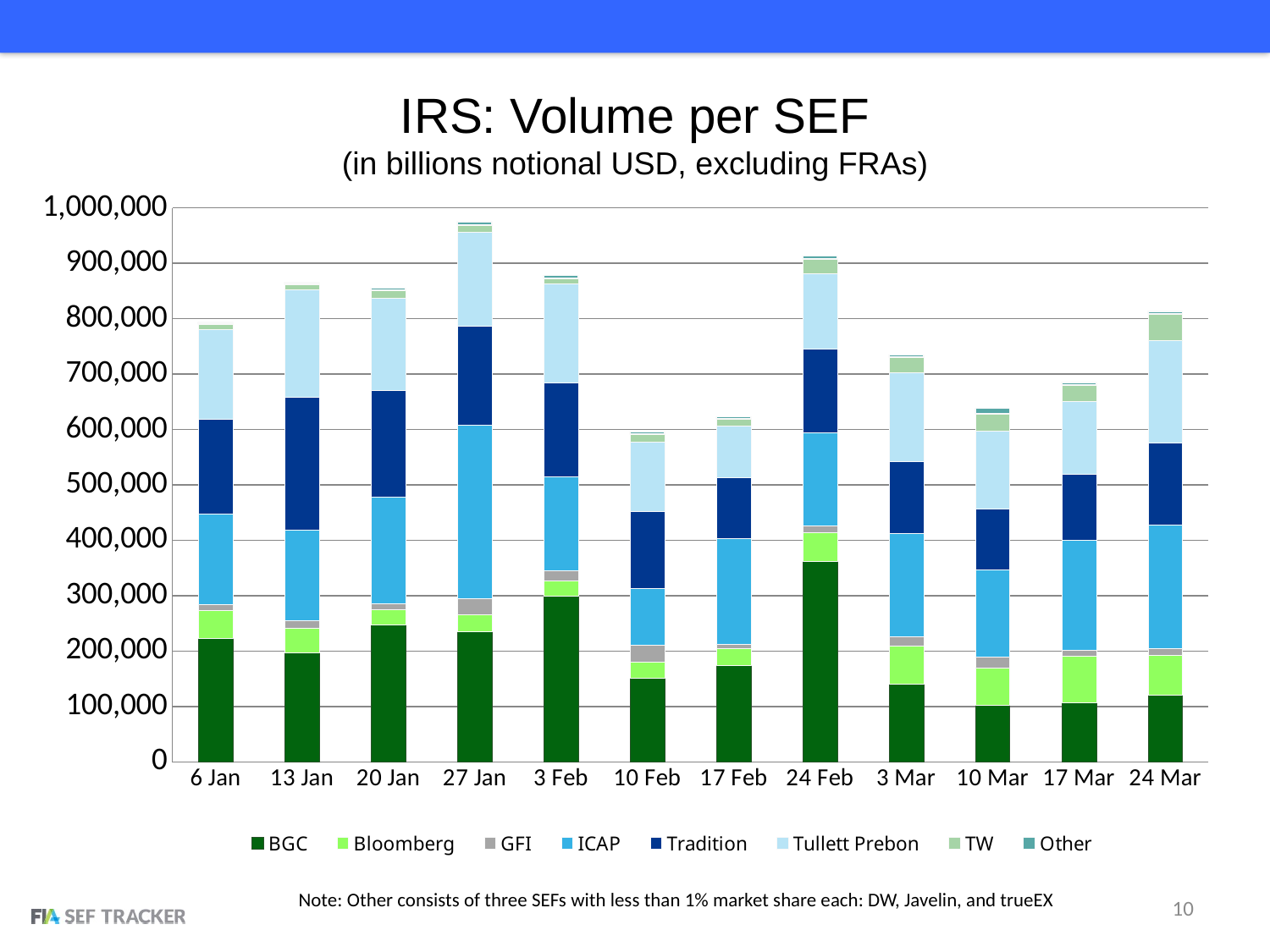
What is the title of the chart? IRS: Volume per SEF On which date is the total stacked bar the highest? 27 Jan Do the total bars rise or fall from 27 Jan to 10 Feb? fall On which date is the total stacked bar the lowest? 10 Feb Is the BGC segment for 24 Feb greater or less than 300,000? greater How many series does the chart's legend list? 8 Is the total bar for 10 Feb greater or less than 700,000? less Which date has the larger total bar, 3 Mar or 10 Mar? 3 Mar Which date has the larger total bar, 27 Jan or 24 Feb? 27 Jan Is the total bar for 27 Jan greater or less than 900,000? greater What kind of chart is shown on the slide? Stacked bar chart How many dates are shown along the x axis of the chart? 12